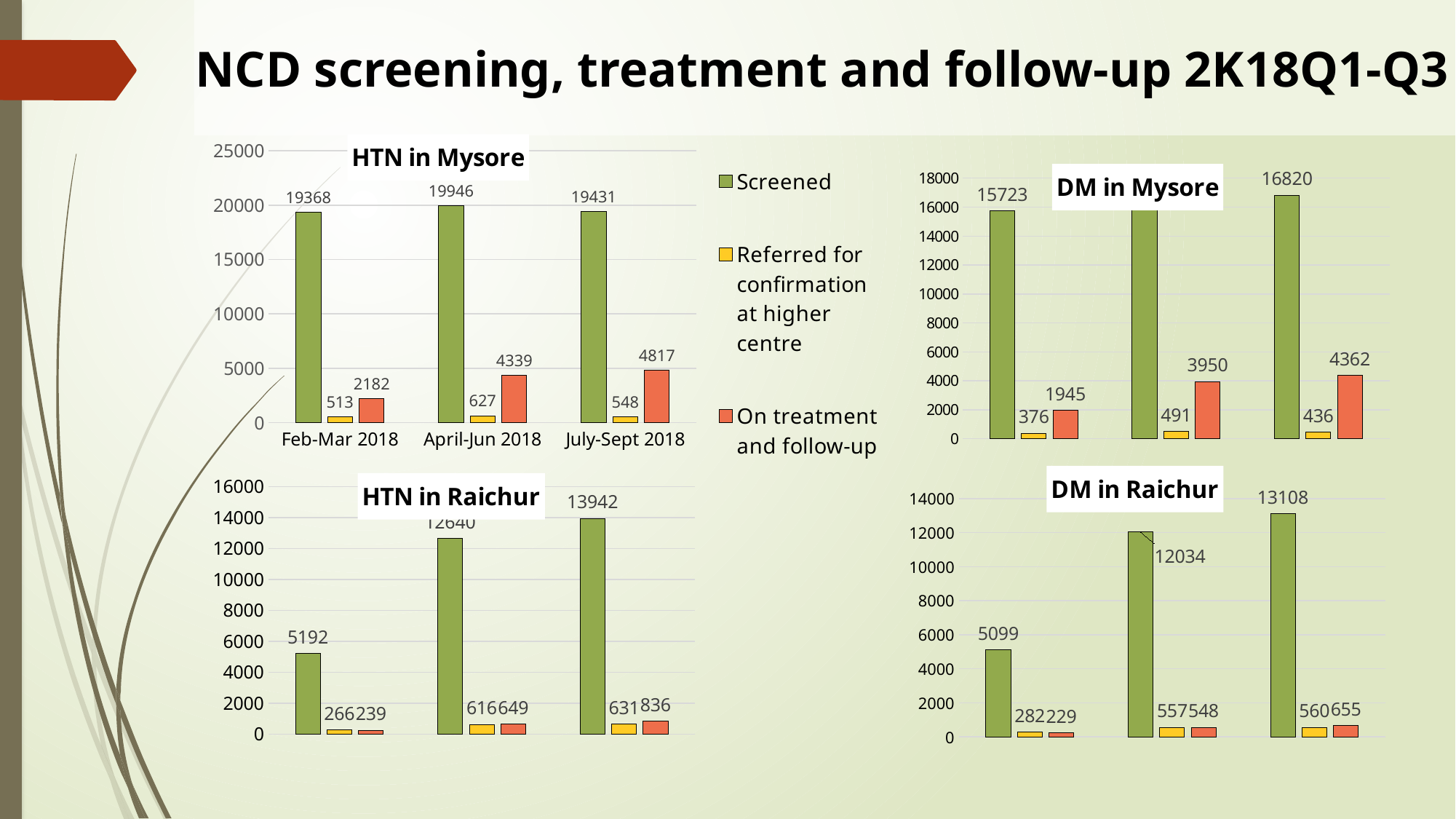
In the HTN in Raichur chart, what is the Screened value for the first (leftmost) group of bars? 5192 In the HTN in Mysore chart, what is the difference between the On treatment and follow-up values for July-Sept 2018 and Feb-Mar 2018? 2635 In the HTN in Mysore chart, how many people were screened in April-Jun 2018? 19946 In the DM in Mysore chart, what is the lowest value for Referred for confirmation at higher centre? 376 In the DM in Mysore chart, what is the Screened value for the third (rightmost) group of bars? 16820 In the HTN in Mysore chart, what is the value for On treatment and follow-up in July-Sept 2018? 4817 How many series does the legend list? 3 In the HTN in Mysore chart, which period has the highest Screened value? April-Jun 2018 In the HTN in Raichur chart, do the Screened values rise or fall from left to right? rise What kind of chart is HTN in Mysore? bar chart In the DM in Raichur chart, is the Screened value for the second group of bars greater or less than 10000? greater In the DM in Raichur chart, what is the On treatment and follow-up value for the third (rightmost) group of bars? 655